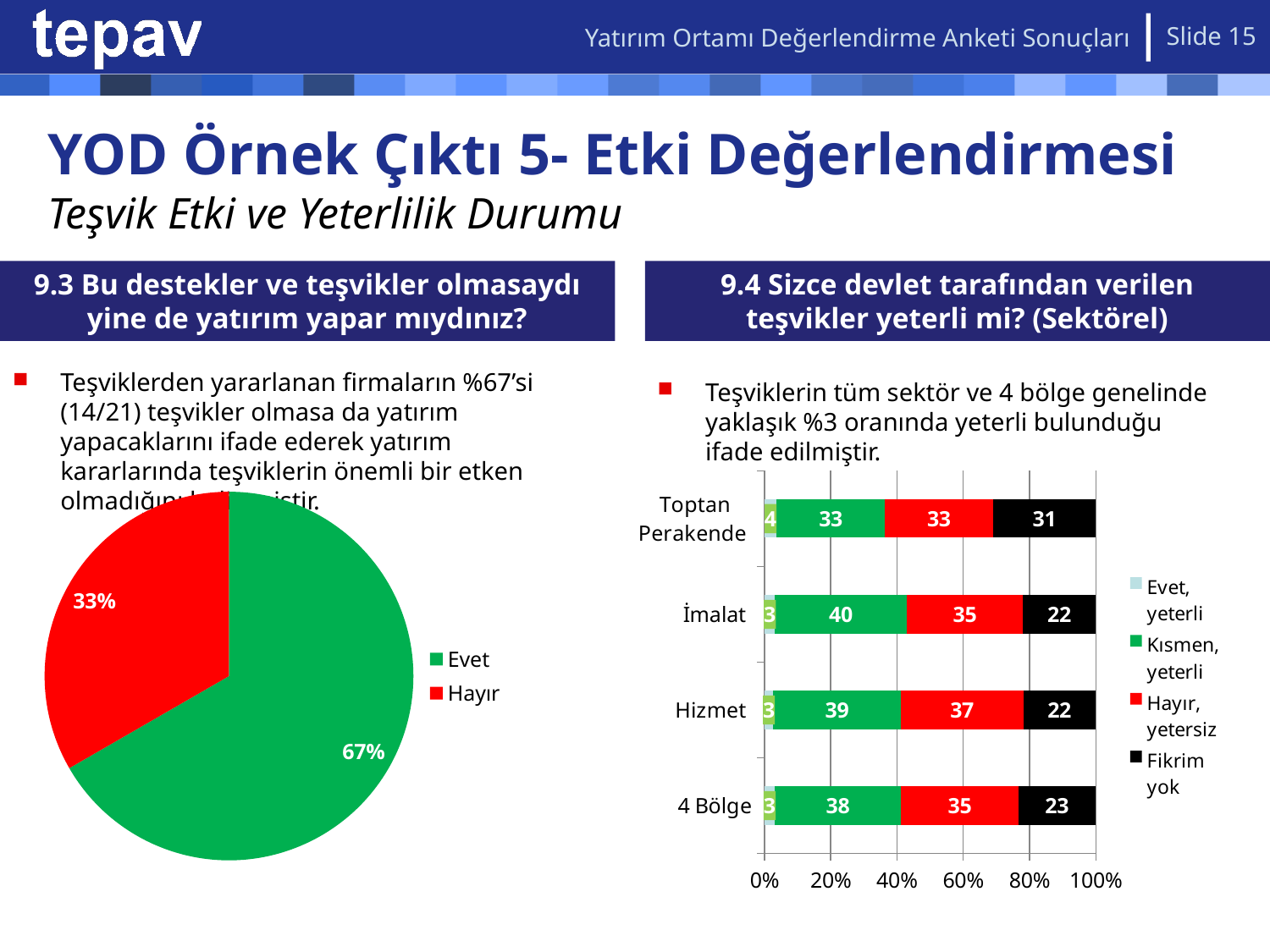
In the pie chart on the left, how many slices are there? 2 In the stacked bar chart on the right, what is the value for Hayır, yetersiz for Hizmet? 37 In the stacked bar chart on the right, what is the value for Kısmen, yeterli for İmalat? 40 In the pie chart on the left, which answer has the larger share, Evet or Hayır? Evet In the pie chart on the left, what share of respondents answered Evet? 67% In the pie chart on the left, what share of respondents answered Hayır? 33% What kind of chart is shown on the left side of the slide? Pie chart In the stacked bar chart on the right, what is the value for Fikrim yok for Toptan Perakende? 31 In the stacked bar chart on the right, how many categories are shown on the vertical axis? 4 How many series does the legend of the stacked bar chart on the right list? 4 In the stacked bar chart on the right, what is the difference between the Hayır, yetersiz values for Hizmet and 4 Bölge? 2 In the stacked bar chart on the right, which category has the highest Kısmen, yeterli value? İmalat